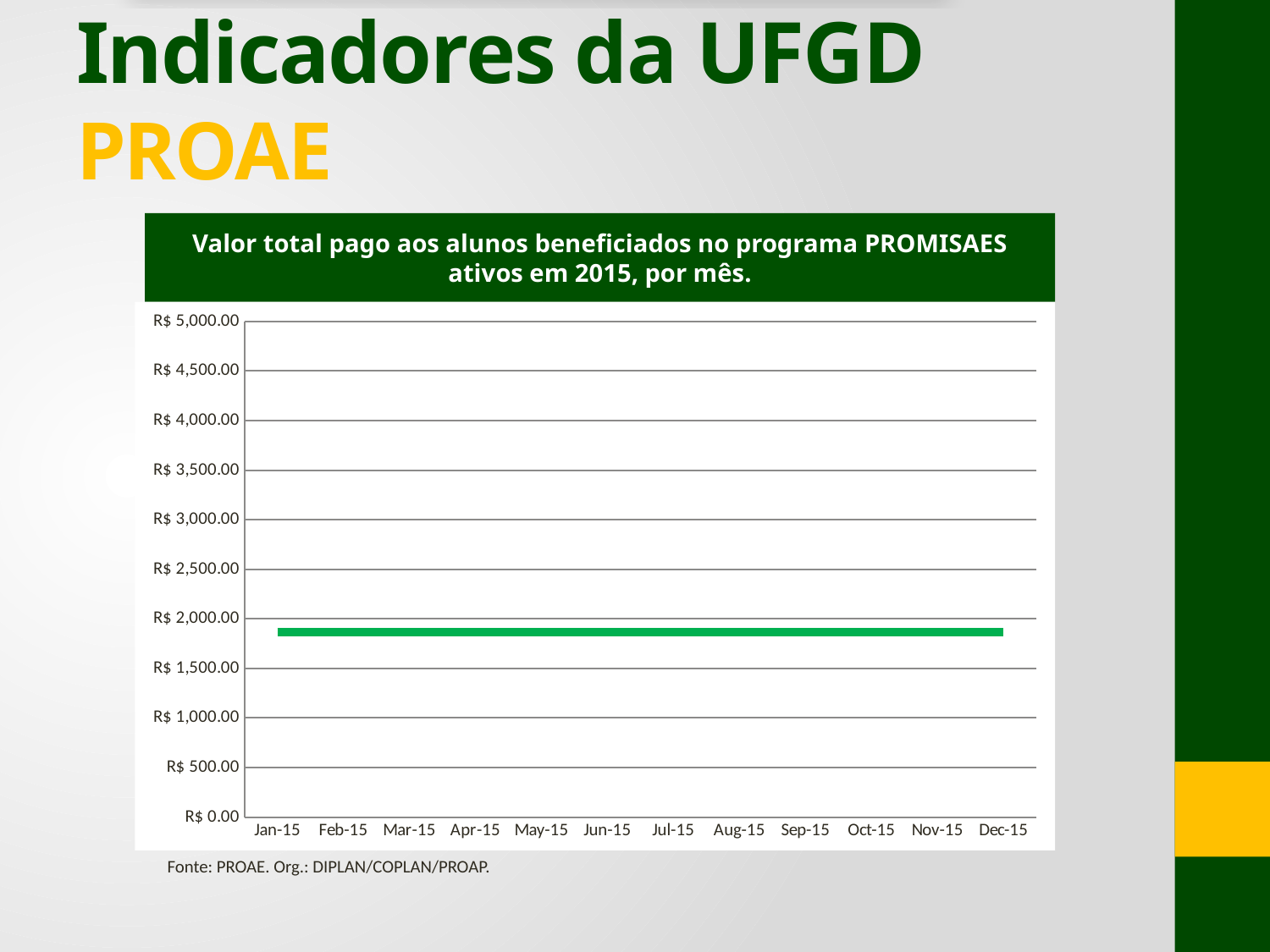
What kind of chart is shown on the slide? line chart How many months are shown on the x axis of the chart? 12 What is the first month shown on the x axis? Jan-15 Do the values rise, fall or stay constant from Jan-15 to Dec-15? stay constant Is the value for Sep-15 greater or less than R$ 1,000.00? greater What is the highest value shown on the y axis of the chart? R$ 5,000.00 Is the value for Jan-15 greater or less than R$ 2,000.00? less Is the value for Jun-15 greater or less than R$ 2,500.00? less